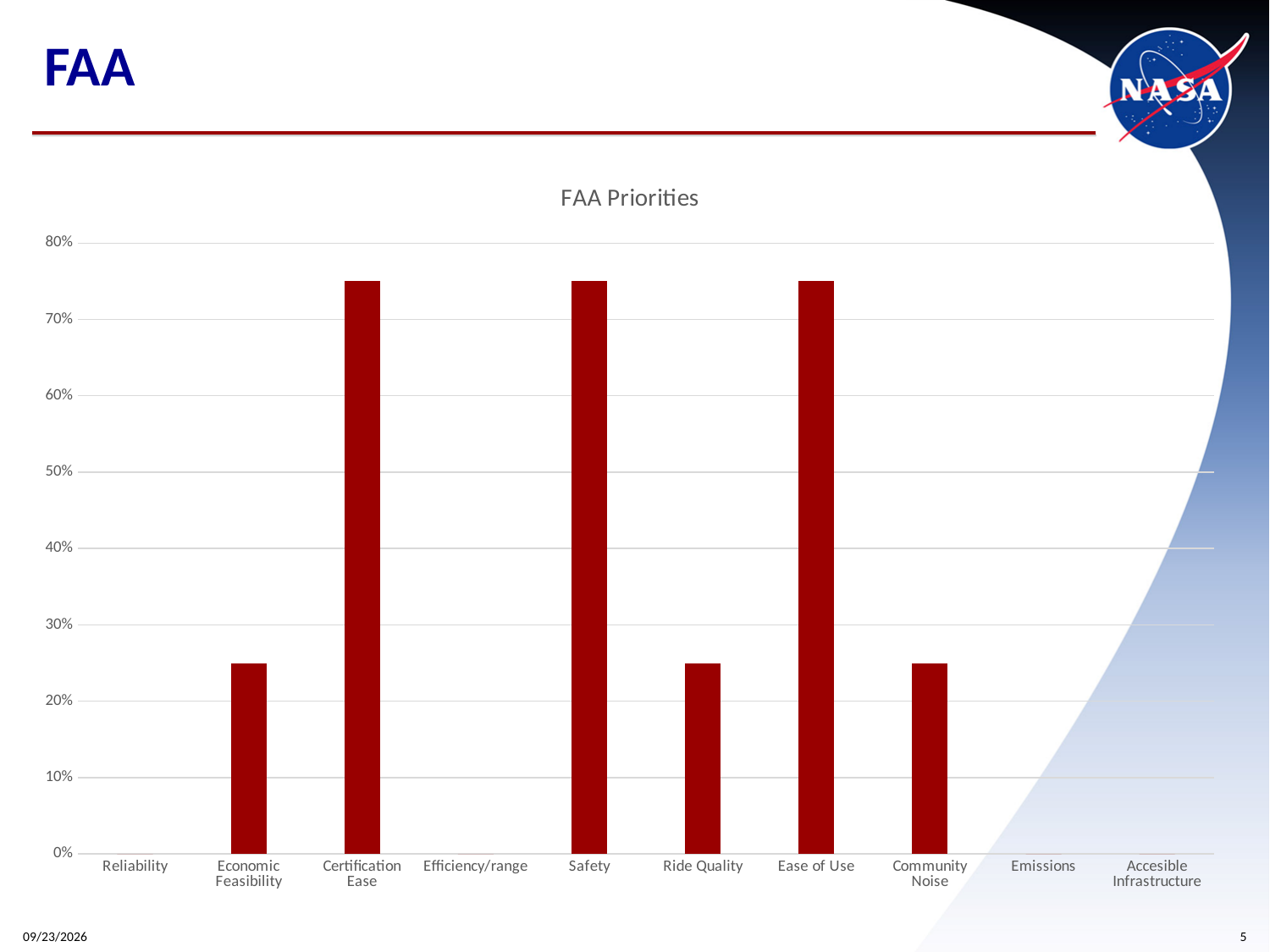
How many categories have a bar that rises above 50%? 3 Is the value for Ride Quality greater or less than 40%? less Is the value for Economic Feasibility greater or less than 30%? less Is the value for Certification Ease greater or less than 70%? greater Which is larger, the value for Economic Feasibility or the value for Ease of Use? Ease of Use How many categories are shown on the x axis of the chart? 10 What kind of chart is shown on the slide? bar chart What is the highest value shown on the y axis? 80% What is the title of the chart? FAA Priorities Which is larger, the value for Safety or the value for Ride Quality? Safety